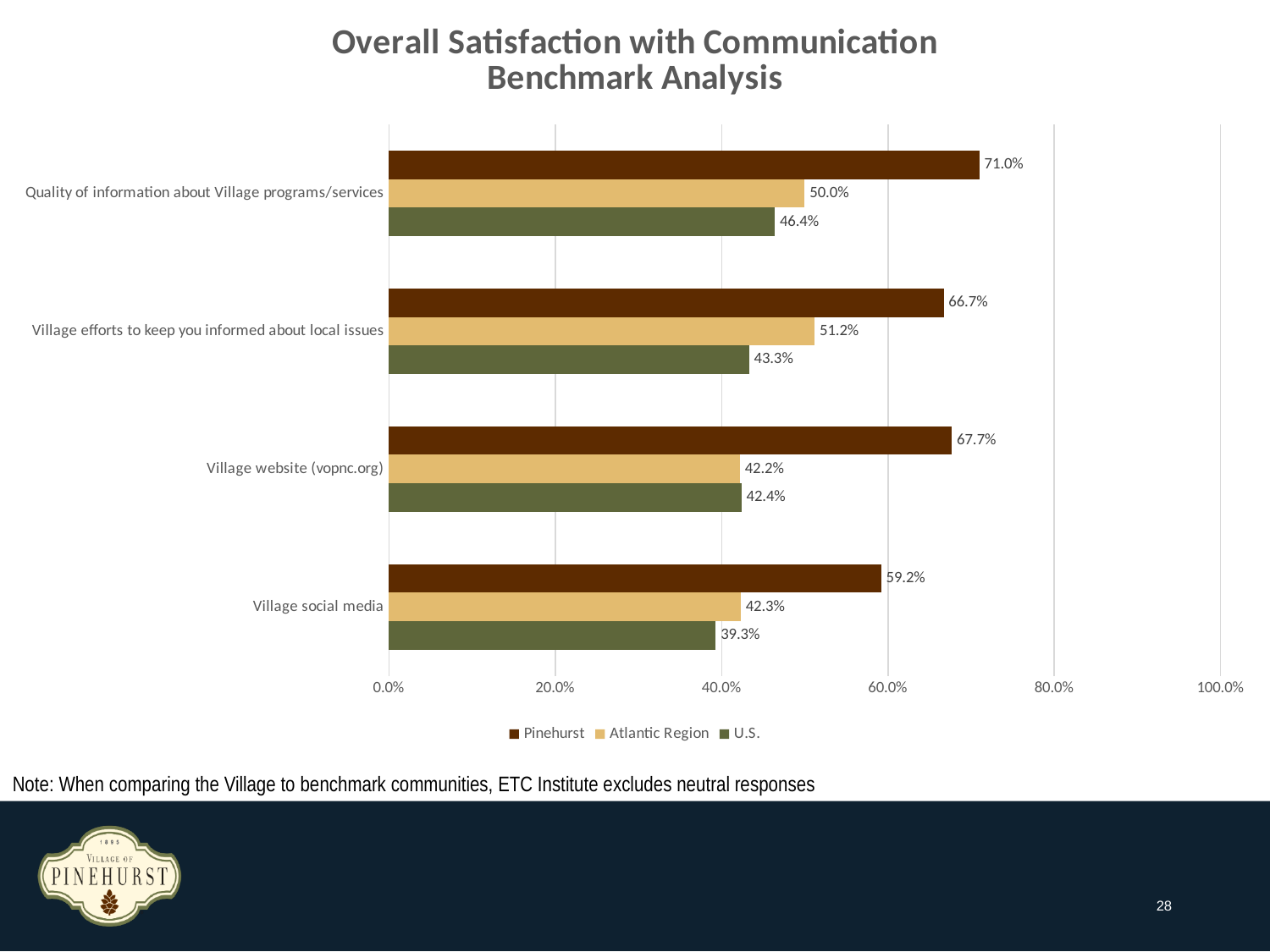
What kind of chart is shown on the slide? Bar chart How many categories are shown on the chart? 4 What is the Atlantic Region value for Village website (vopnc.org)? 42.2% Which category has the lowest U.S. value? Village social media How many series does the legend list? 3 What is the difference between the Pinehurst and U.S. values for Village social media? 19.9% What is the U.S. value for Village social media? 39.3% Which is larger for Village efforts to keep you informed about local issues: the Atlantic Region value or the U.S. value? Atlantic Region What is the Atlantic Region value for Village efforts to keep you informed about local issues? 51.2% What is the Pinehurst value for Quality of information about Village programs/services? 71.0% What is the title of the chart? Overall Satisfaction with Communication Benchmark Analysis Which category has the highest Pinehurst value? Quality of information about Village programs/services